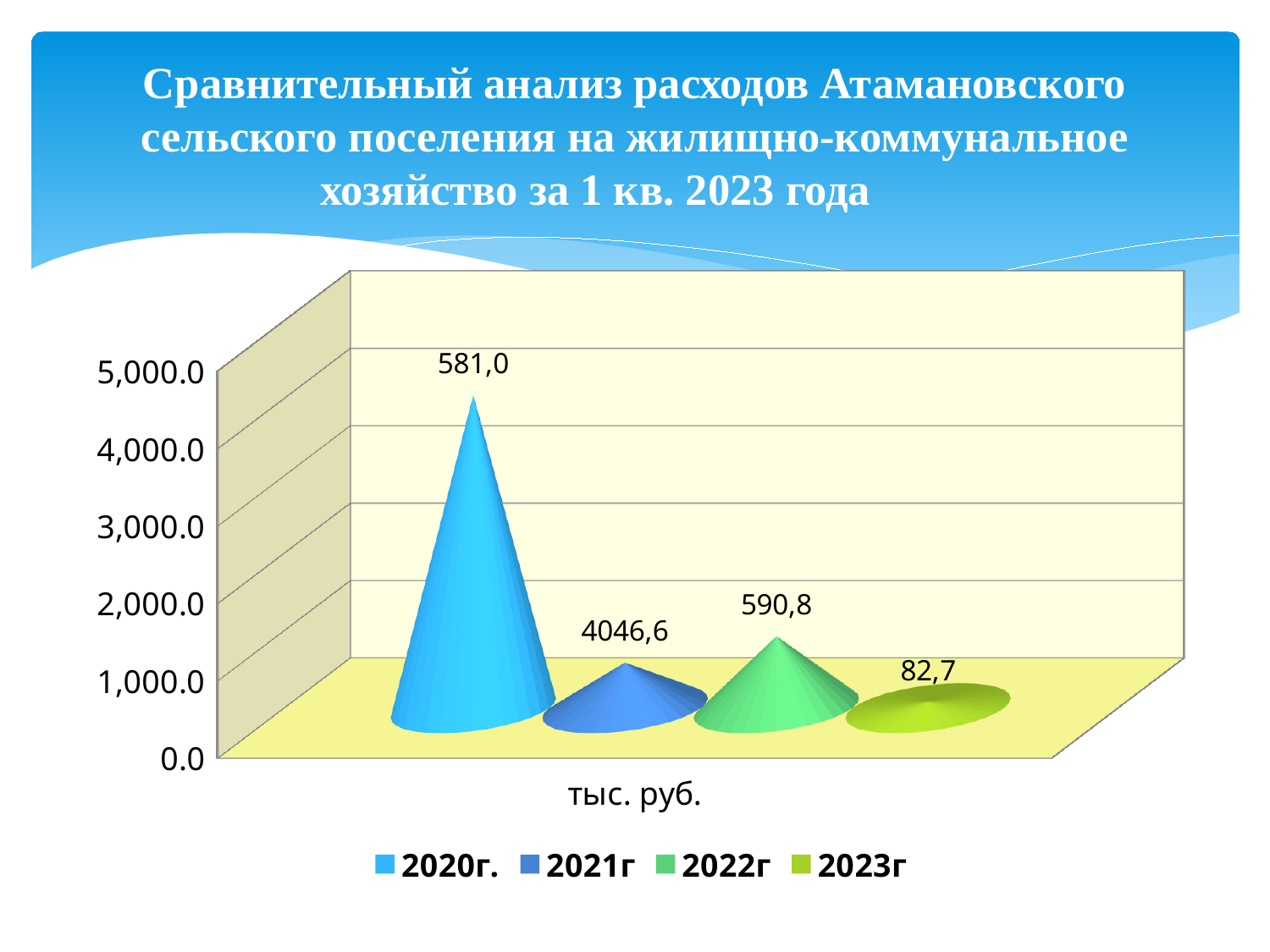
What value is labelled on the cone for 2021г? 4046,6 What value is labelled on the cone for 2022г? 590,8 What value is labelled on the cone for 2023г? 82,7 What unit label appears below the chart's category axis? тыс. руб. What kind of chart is shown on the slide? 3D bar chart (cone-shaped bars) How many cones (data points) are plotted on the chart? 4 What value is labelled on the cone for 2020г.? 581,0 How many series does the legend list? 4 What is the difference between the labelled values for 2022г and 2020г.? 9,8 What is the highest value shown on the vertical axis? 5,000.0